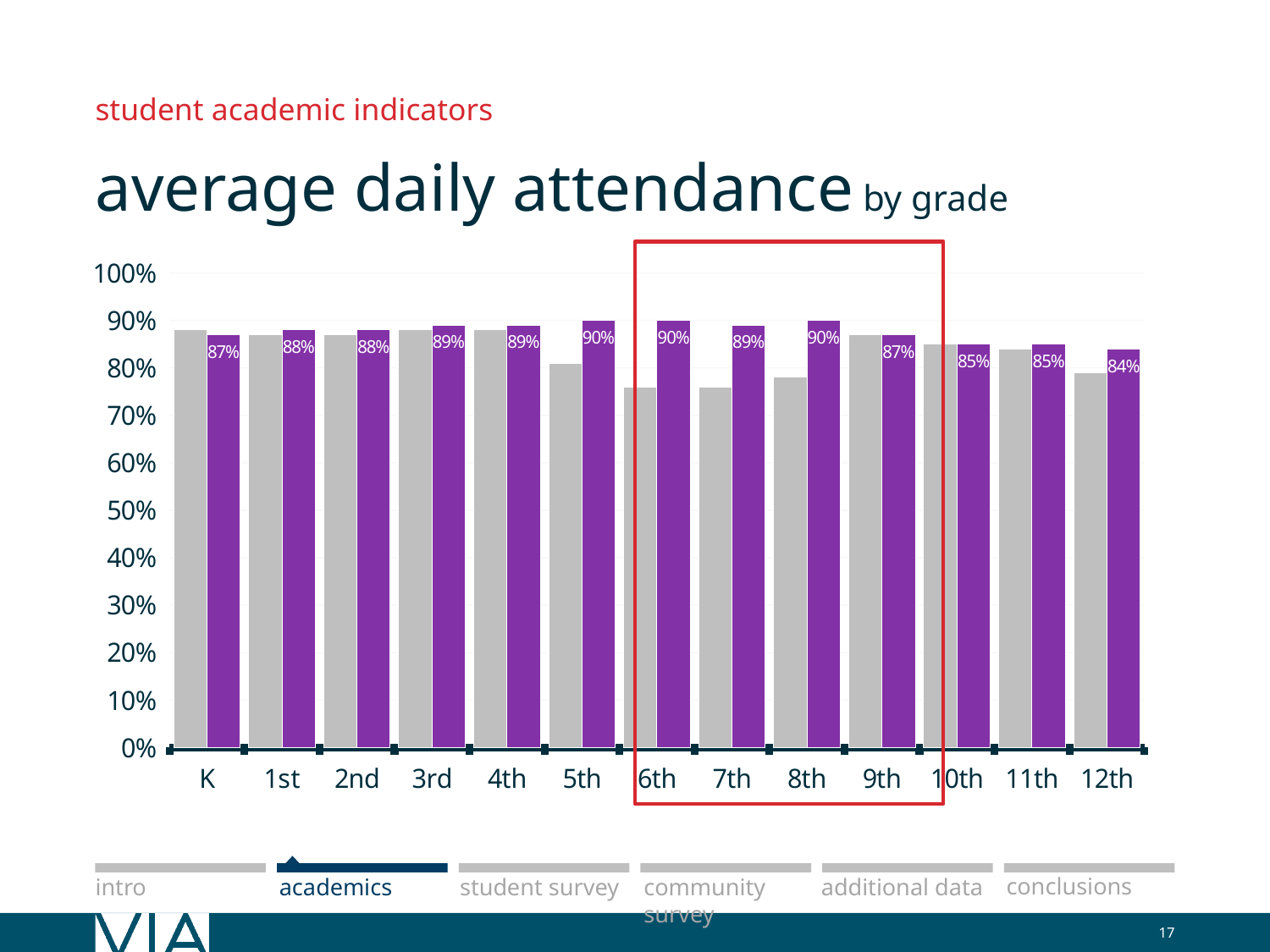
Which grades are enclosed by the red box on the chart? 6th, 7th, 8th and 9th Which is larger, the purple bar for 3rd grade or the purple bar for 12th grade? 3rd grade What is the value of the purple bar for 12th grade? 84% Is the gray bar for 6th grade greater or less than 80%? less What is the value of the purple bar for K (kindergarten)? 87% Is the gray bar for K greater or less than 80%? greater How many grade categories are shown on the x axis? 13 Which grade has the lowest labelled purple bar? 12th What is the difference between the purple bar values for 5th grade and 12th grade? 6 percentage points What kind of chart is shown on the slide? Bar chart What is the value of the purple bar for 10th grade? 85% What is the value of the purple bar for 5th grade? 90%